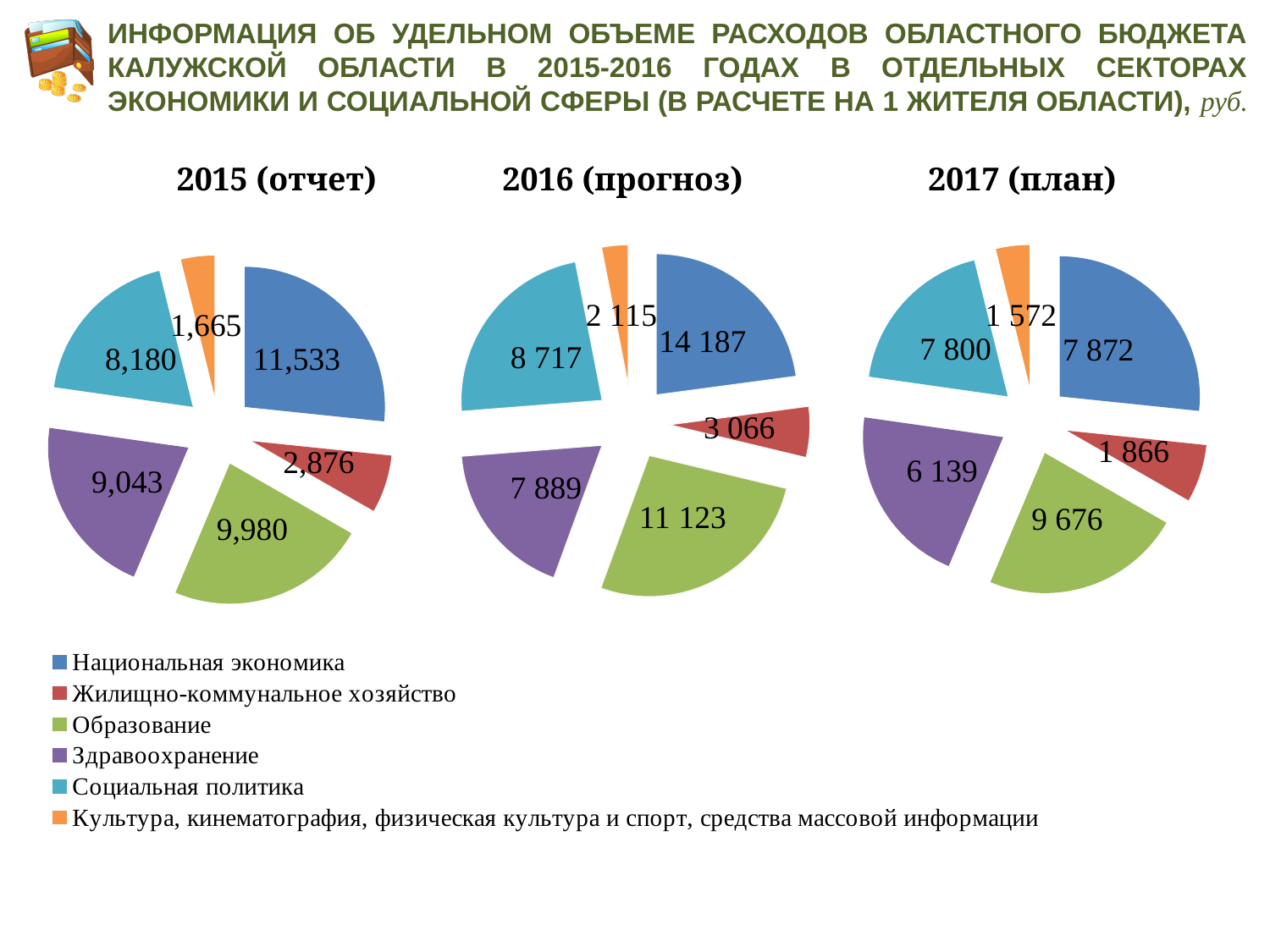
In the 2017 (план) pie chart, what is the difference between Социальная политика and Здравоохранение? 1 661 How many slices does the 2016 (прогноз) pie chart have? 6 In the 2016 (прогноз) pie chart, which category has the smallest value? Культура, кинематография, физическая культура и спорт, средства массовой информации In the 2016 (прогноз) pie chart, what is the value for Образование? 11 123 How many entries does the legend list? 6 In the 2015 (отчет) pie chart, what is the value for Национальная экономика? 11,533 In the 2017 (план) pie chart, which category has the largest value? Образование In the 2016 (прогноз) pie chart, what is the difference between Национальная экономика and Образование? 3 064 In the 2017 (план) pie chart, what is the value for Здравоохранение? 6 139 In the 2015 (отчет) pie chart, which category has the largest value? Национальная экономика What kind of chart is used for 2017 (план)? Pie chart In the 2015 (отчет) pie chart, which is larger: Образование or Здравоохранение? Образование